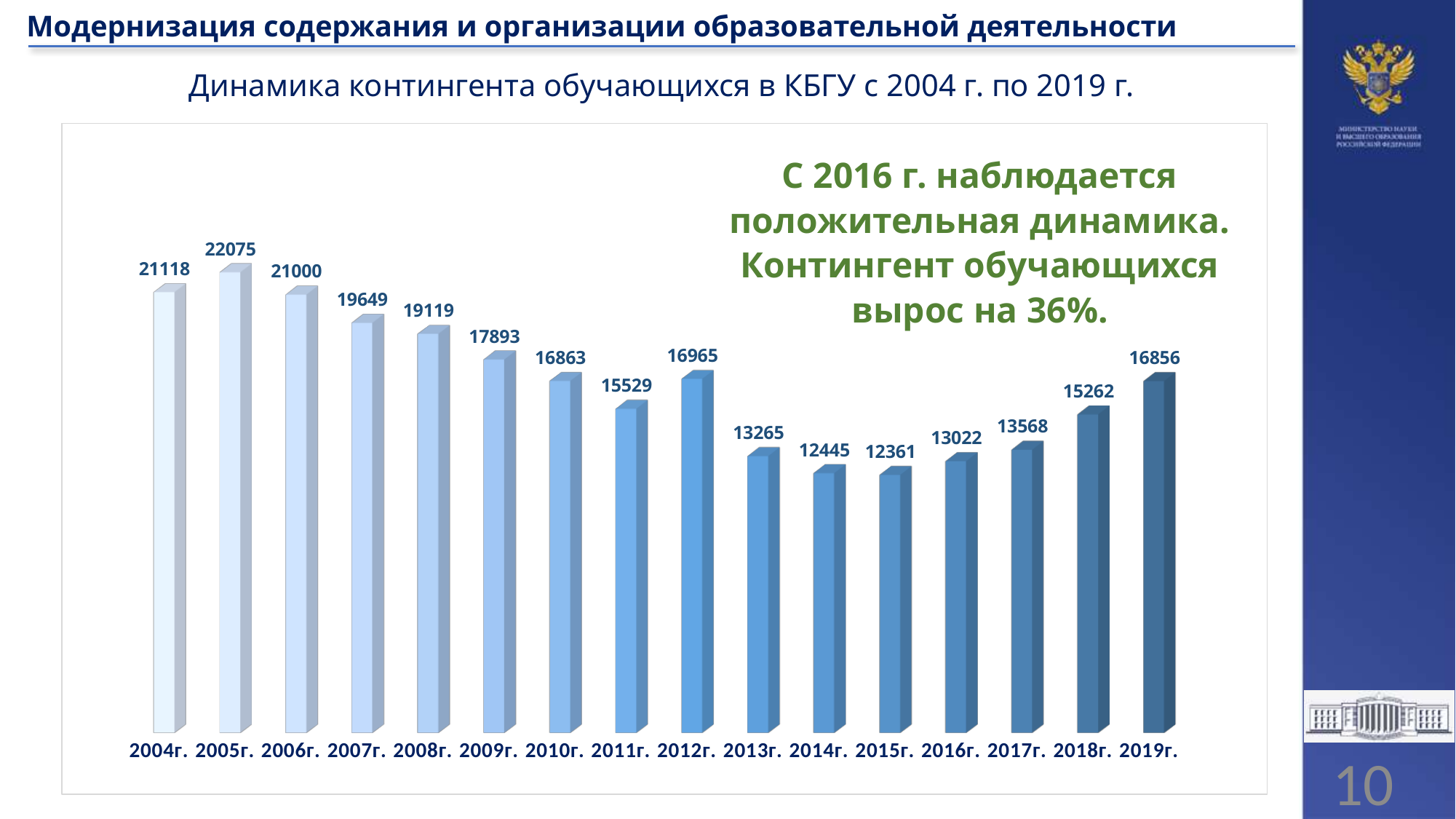
What is the value shown for 2016г. in the chart? 13022 Which year has the highest value in the chart? 2005г. What kind of chart is shown on the slide? Bar chart Which year has the lowest value in the chart? 2015г. What is the value shown for 2019г. in the chart? 16856 What is the difference between the values for 2005г. and 2004г.? 957 Which is larger, the value for 2018г. or the value for 2013г.? 2018г. What is the difference between the values for 2019г. and 2016г.? 3834 What is the title of the chart on the slide? Динамика контингента обучающихся в КБГУ с 2004 г. по 2019 г. What is the value shown for 2012г. in the chart? 16965 How many years (bars) are shown in the chart? 16 Do the values rise or fall from 2016г. to 2019г.? Rise